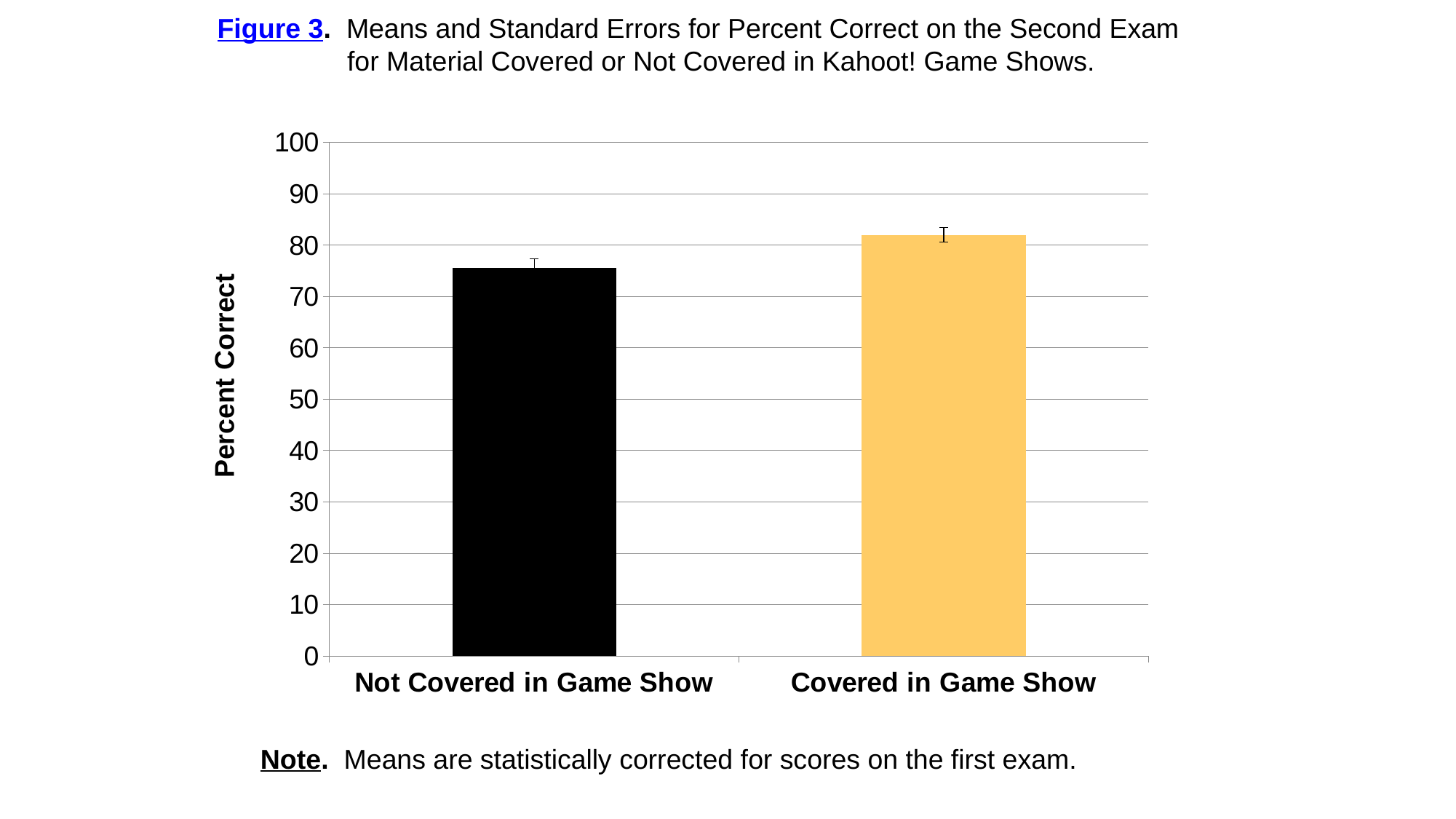
Is the value for Covered in Game Show greater or less than 80? greater Is the value for Covered in Game Show greater or less than 90? less Which is larger, the value for Covered in Game Show or the value for Not Covered in Game Show? Covered in Game Show Is the value for Not Covered in Game Show greater or less than 70? greater What kind of chart is shown on the slide? bar chart Which category has the lower percent correct? Not Covered in Game Show What is the maximum value shown on the y axis? 100 How many categories are shown on the x axis? 2 What is the label of the y axis? Percent Correct Which category has the higher percent correct? Covered in Game Show What colour is the bar for Covered in Game Show? yellow